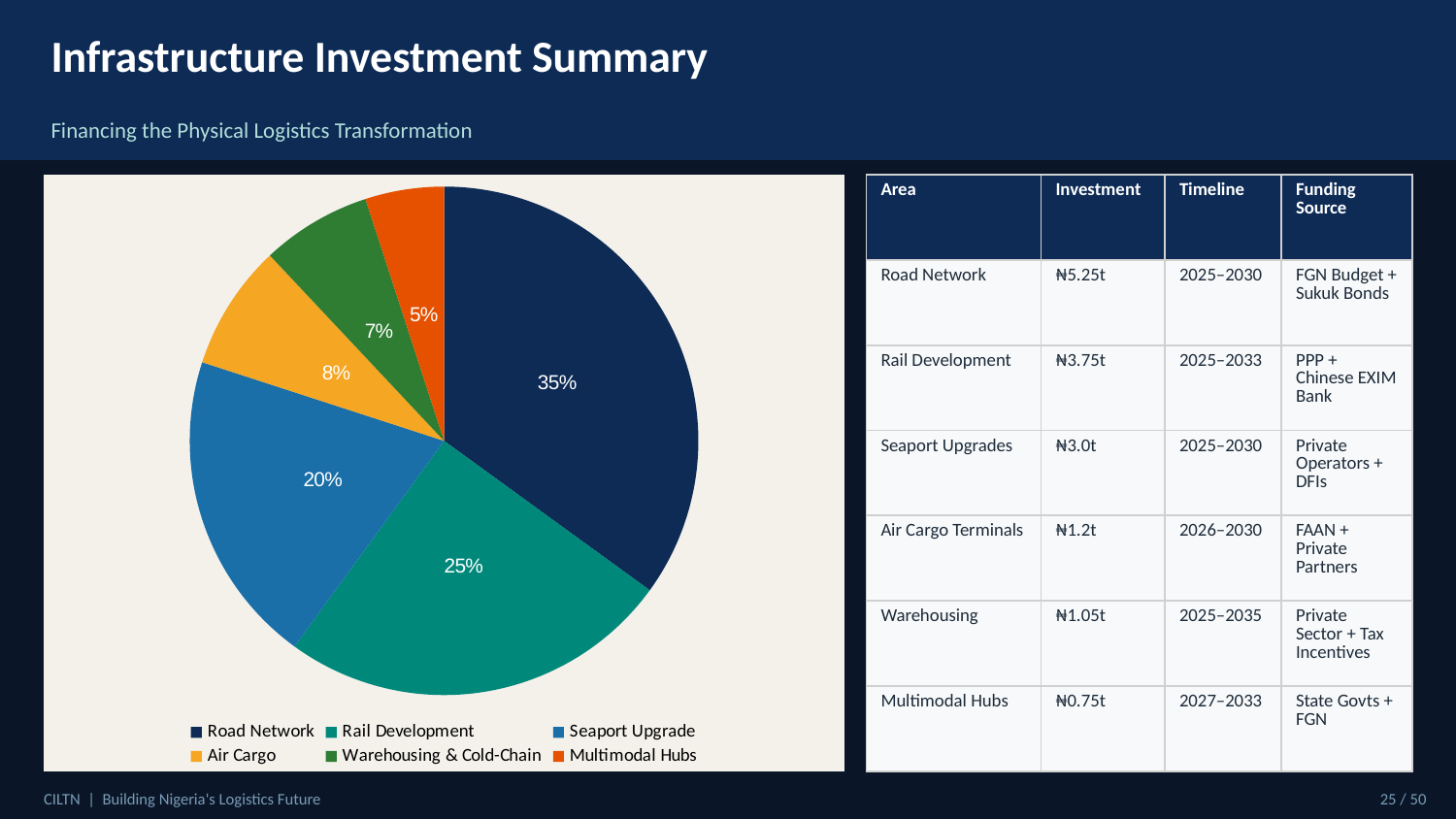
What share of the pie does Air Cargo represent? 8% What share of the pie does Rail Development represent? 25% Which category has the smallest slice of the pie? Multimodal Hubs What share of the pie does Multimodal Hubs represent? 5% What kind of chart is shown on the slide? pie chart What is the difference in percentage points between the Road Network and Rail Development slices? 10 What colour is the Multimodal Hubs slice in the pie chart? orange-red Which slice is larger, Air Cargo or Warehousing & Cold-Chain? Air Cargo Which category has the largest slice of the pie? Road Network How many slices does the pie chart have? 6 What share of the pie does Road Network represent? 35% What share of the pie does Seaport Upgrade represent? 20%